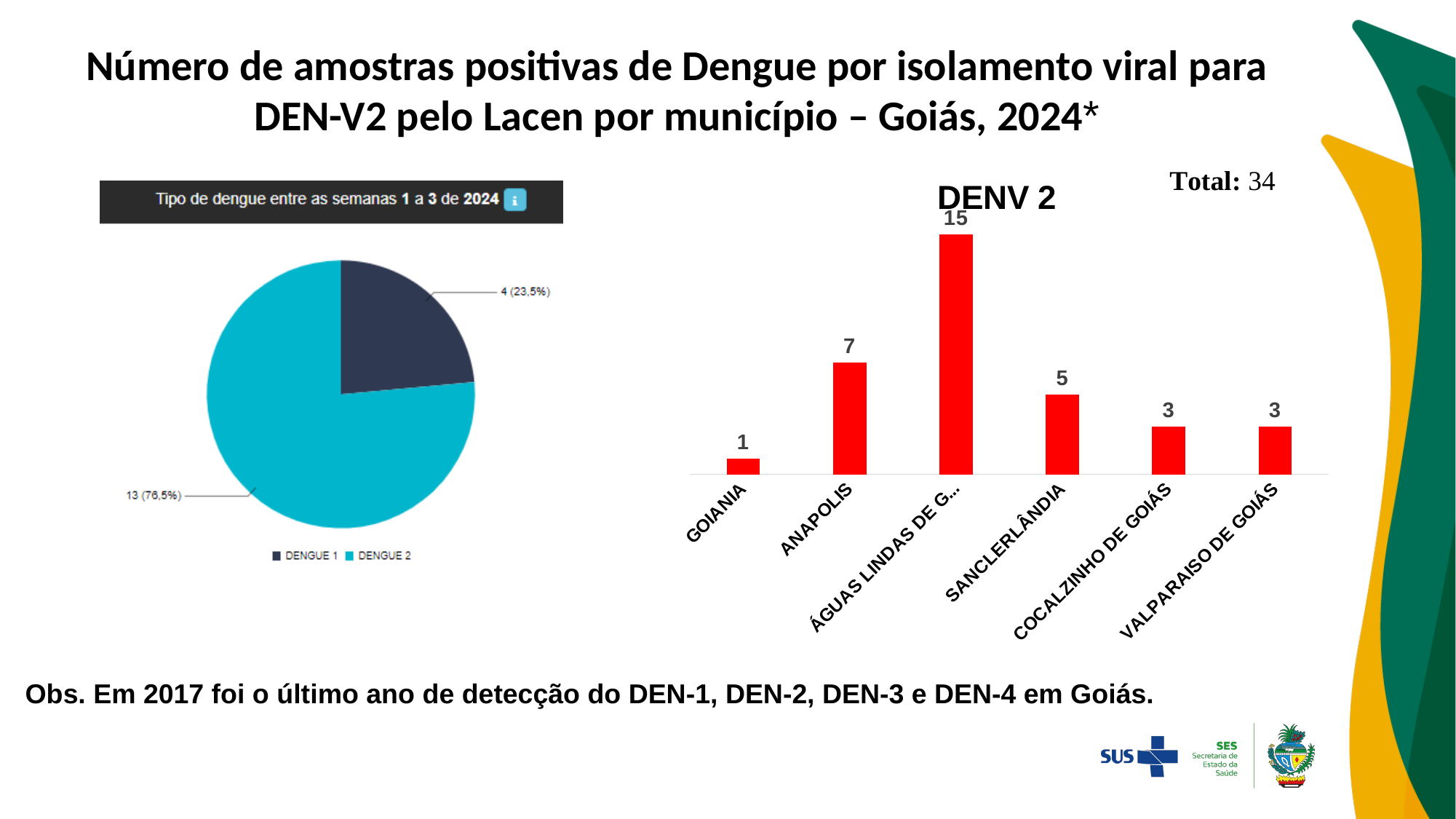
In the pie chart on the left, what share of the pie does DENGUE 1 represent? 23,5% How many entries does the legend of the pie chart on the left list? 2 In the DENV 2 bar chart, which municipality has the lowest value? GOIANIA In the DENV 2 bar chart, which is larger, the value for SANCLERLÂNDIA or the value for COCALZINHO DE GOIÁS? SANCLERLÂNDIA In the pie chart on the left, what value and share are shown for DENGUE 2? 13 (76,5%) In the DENV 2 bar chart, what is the difference between the values for ÁGUAS LINDAS DE G... and ANAPOLIS? 8 In the DENV 2 bar chart, what is the value for ANAPOLIS? 7 What total is printed next to the DENV 2 bar chart? 34 How many municipalities are shown in the DENV 2 bar chart? 6 In the DENV 2 bar chart, what is the value for SANCLERLÂNDIA? 5 What kind of chart is the DENV 2 chart on the right? Bar chart In the DENV 2 bar chart, which municipality has the highest value? ÁGUAS LINDAS DE G...